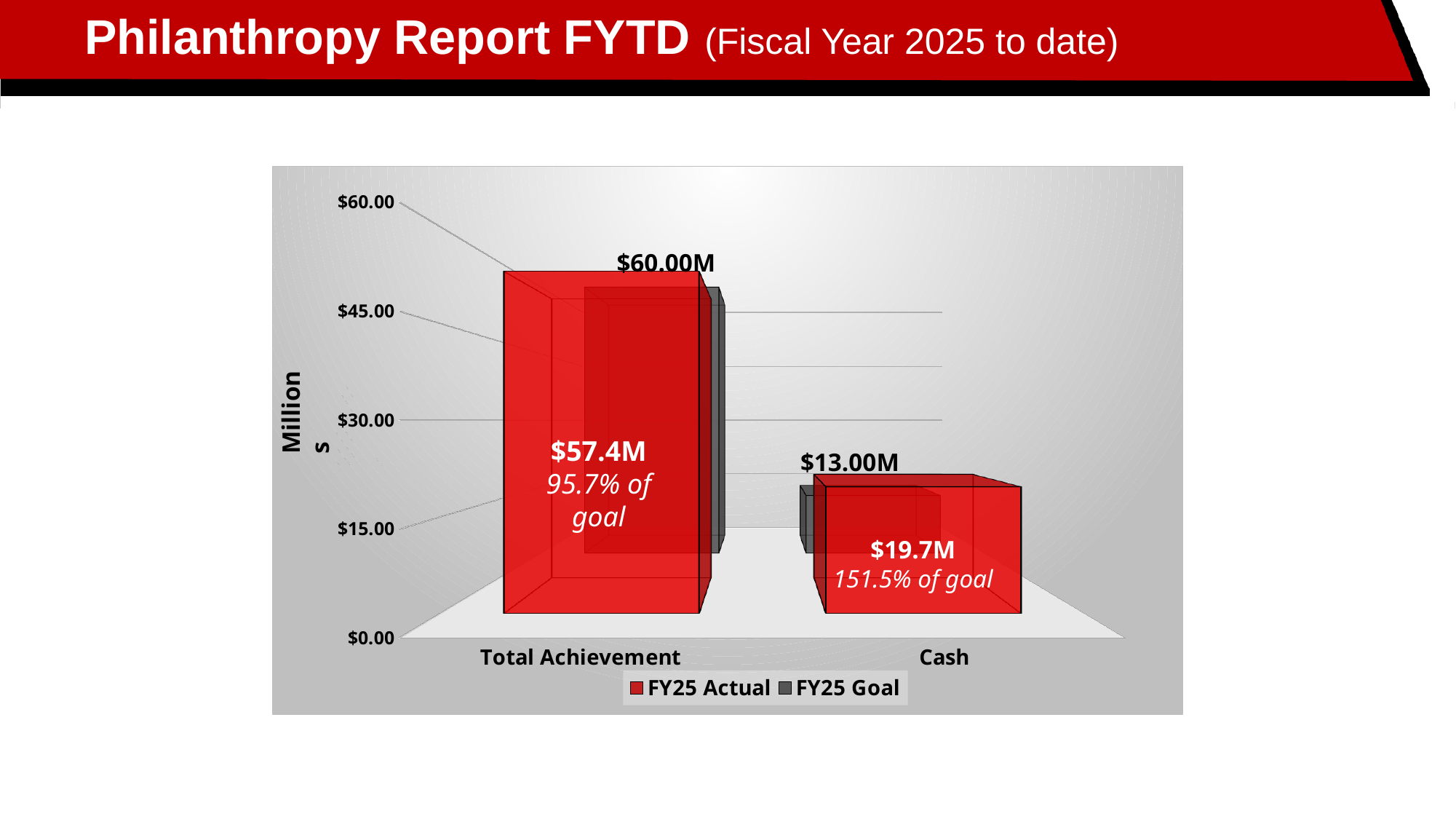
What is the difference between the FY25 Goal and the FY25 Actual for Total Achievement? $2.6M What kind of chart is shown on the slide? Bar chart What is the FY25 Goal value for Total Achievement? $60.00M How many series does the legend list? 2 For Total Achievement, which is larger: the FY25 Actual or the FY25 Goal? FY25 Goal Which category has the higher FY25 Actual value? Total Achievement What is the FY25 Goal value for Cash? $13.00M For Cash, which is larger: the FY25 Actual or the FY25 Goal? FY25 Actual What is the FY25 Actual value for Cash? $19.7M What is the FY25 Actual value for Total Achievement? $57.4M What percentage of goal has the FY25 Actual for Cash reached? 151.5% of goal How many categories are shown on the x axis? 2